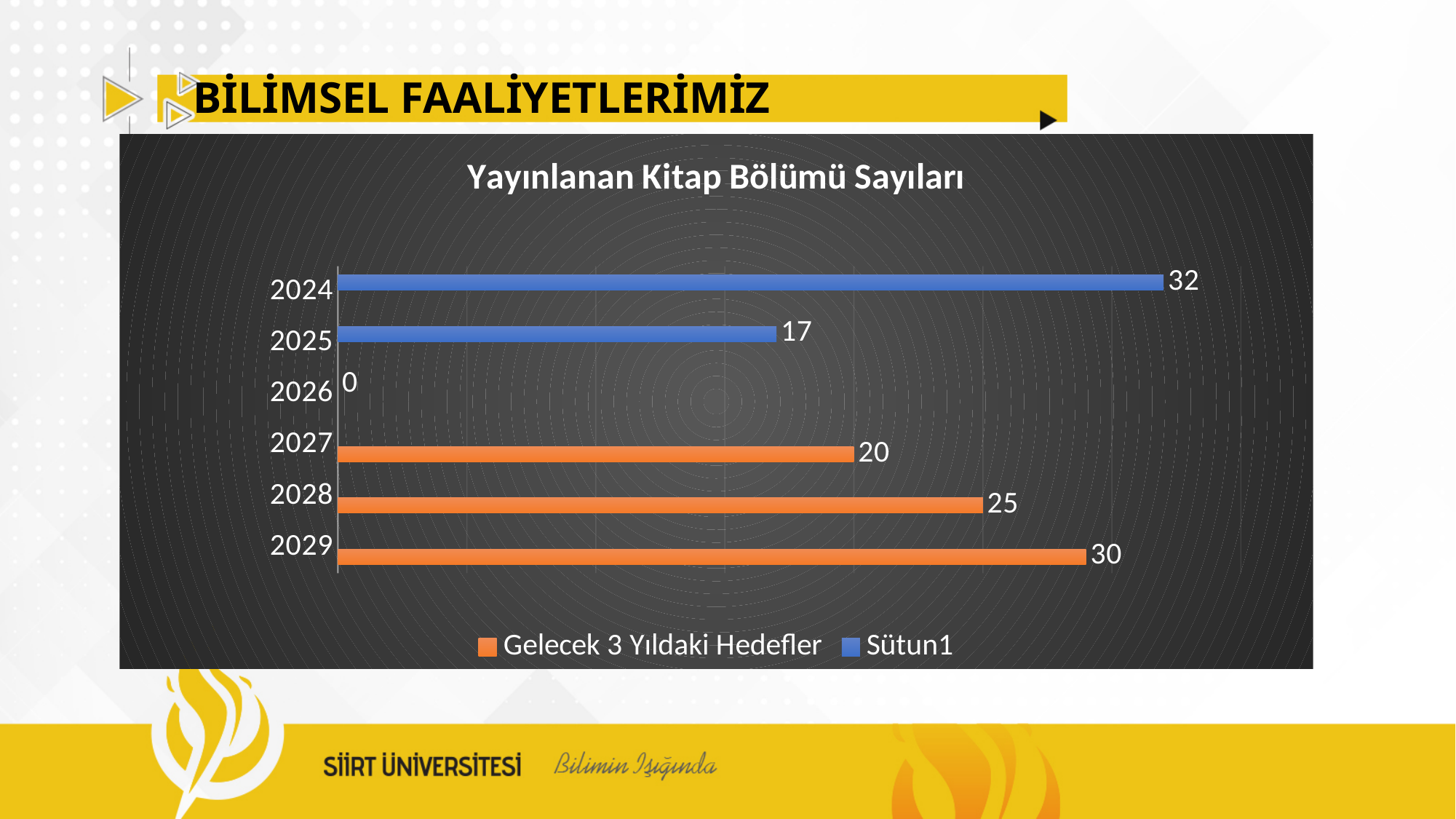
What is the value shown for 2025 in the chart? 17 How many years are shown on the chart's axis? 6 What is the difference between the values for 2029 and 2027? 10 Which year has the highest value in the chart? 2024 What is the difference between the values for 2024 and 2025? 15 What type of chart is shown on the slide? Bar chart What is the value shown for 2024 in the chart? 32 How many series does the legend list? 2 What is the value for 2029 in the Gelecek 3 Yıldaki Hedefler series? 30 Which year has the lowest value in the chart? 2026 What value is shown for 2026? 0 Which is larger, the value for 2028 or the value for 2025? 2028